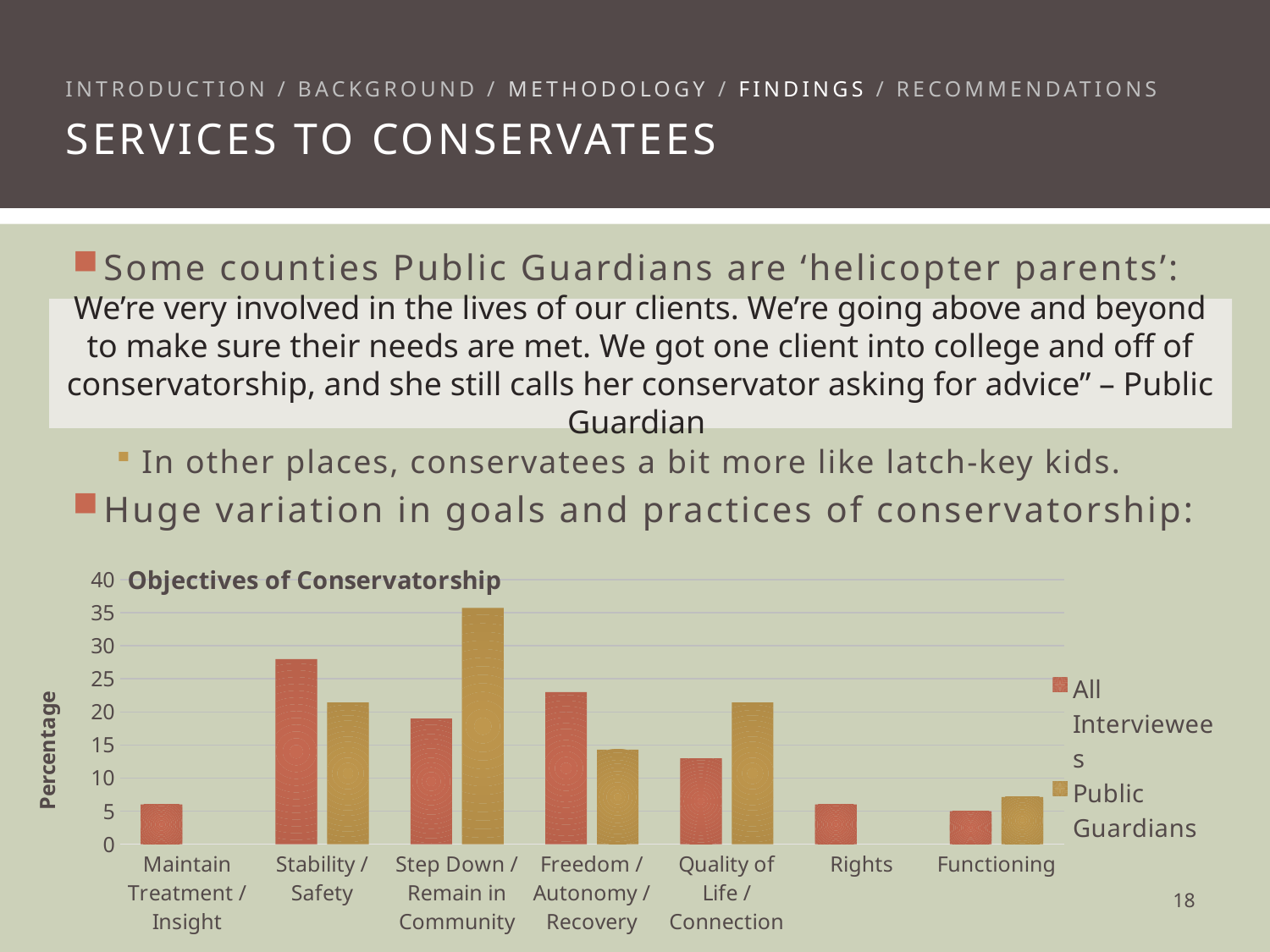
How many categories are shown on the x axis of the chart? 7 What is the title of the chart? Objectives of Conservatorship What kind of chart is shown on the slide? bar chart Which category has the highest value for the All Interviewees series? Stability / Safety What is the label of the vertical axis of the chart? Percentage For Freedom / Autonomy / Recovery, which series has the larger value, All Interviewees or Public Guardians? All Interviewees Which category has the highest value for the Public Guardians series? Step Down / Remain in Community How many series does the chart legend list? 2 For Quality of Life / Connection, which series has the larger value, All Interviewees or Public Guardians? Public Guardians Is the All Interviewees value for Quality of Life / Connection greater or less than 15? less Is the All Interviewees value for Stability / Safety greater or less than 25? greater